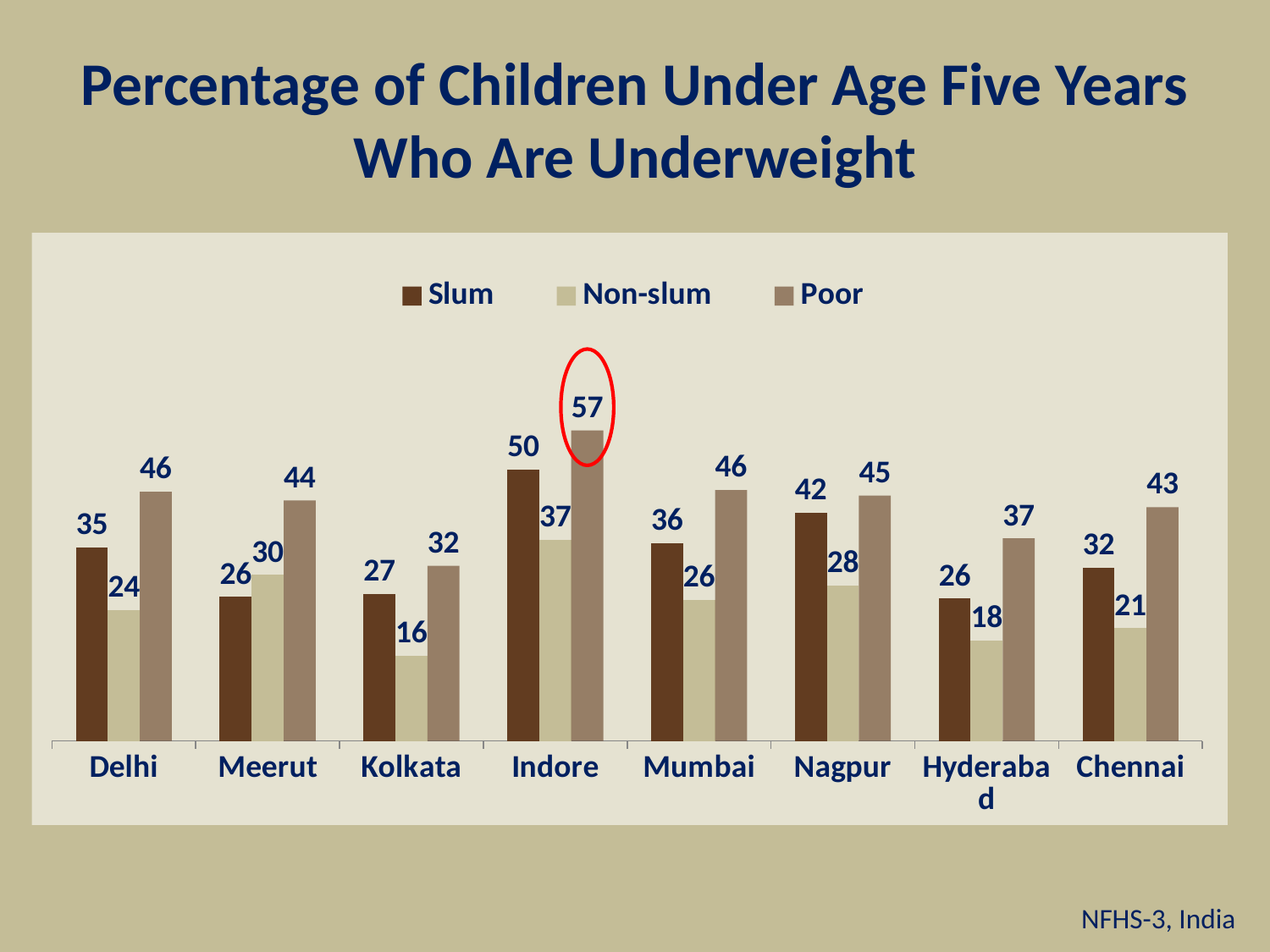
What is the Non-slum value for Kolkata? 16 What kind of chart is shown on the slide? Bar chart Which is larger, the Slum value for Nagpur or the Slum value for Mumbai? Nagpur What is the Poor value for Chennai? 43 Which city has the highest Poor value? Indore Which series is highlighted with a red circle? Poor (Indore, 57) Which city has the lowest Non-slum value? Kolkata What is the difference between the Slum and Non-slum values for Hyderabad? 8 What is the difference between the Poor and Slum values for Delhi? 11 What is the Slum value for Indore? 50 How many cities are shown on the x axis? 8 How many series does the legend list? 3